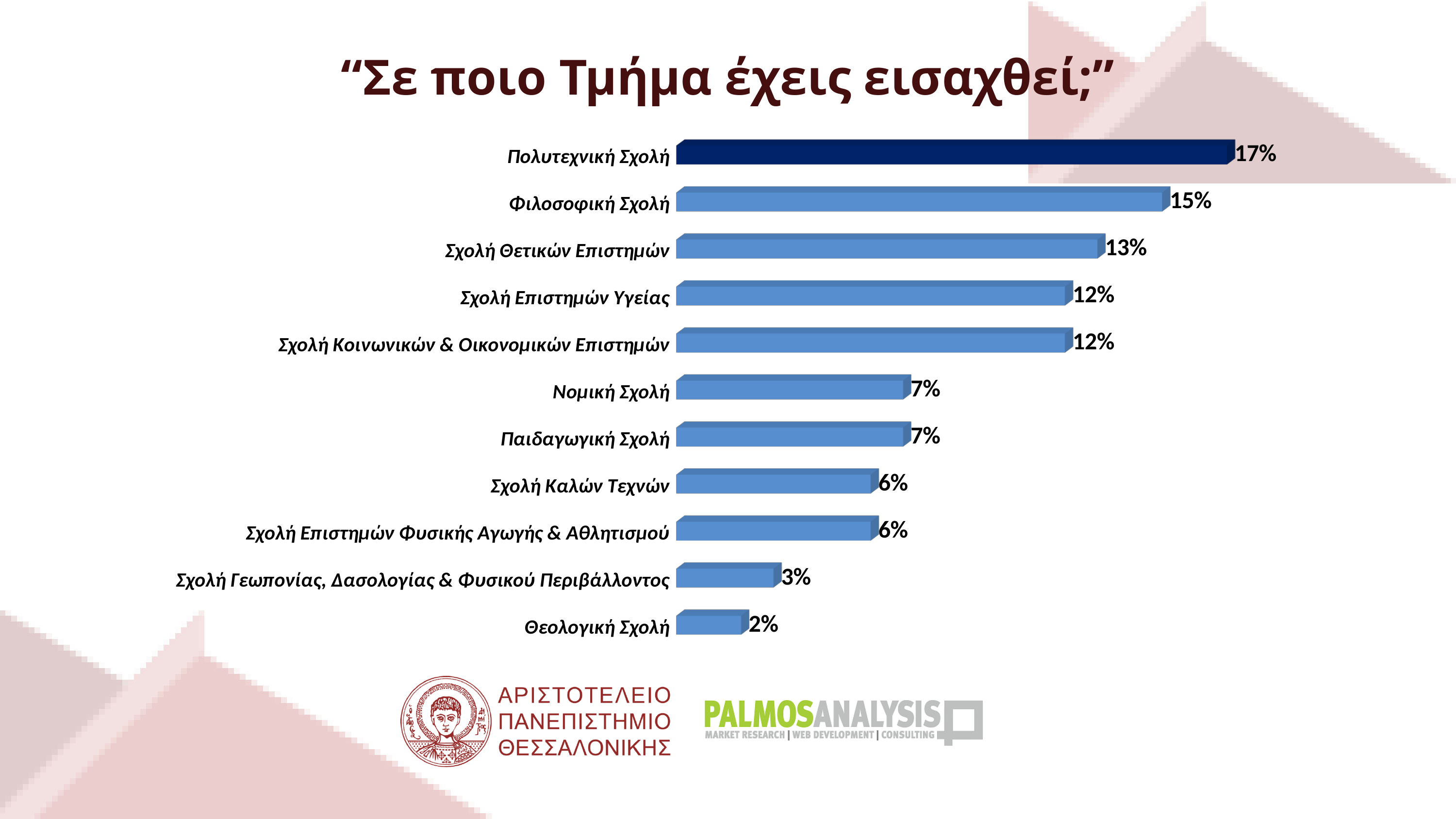
What is the difference between the values for Σχολή Επιστημών Υγείας and Νομική Σχολή? 5% How many categories are shown in the chart? 11 What is the title of the chart? "Σε ποιο Τμήμα έχεις εισαχθεί;" What kind of chart is shown on the slide? Bar chart Which category has the highest value? Πολυτεχνική Σχολή Which category has the lowest value? Θεολογική Σχολή What is the value for Θεολογική Σχολή? 2% Which is larger, the value for Φιλοσοφική Σχολή or the value for Σχολή Θετικών Επιστημών? Φιλοσοφική Σχολή What is the value for Πολυτεχνική Σχολή? 17% What is the value for Σχολή Θετικών Επιστημών? 13% What is the value for Σχολή Γεωπονίας, Δασολογίας & Φυσικού Περιβάλλοντος? 3% What is the difference between the values for Πολυτεχνική Σχολή and Φιλοσοφική Σχολή? 2%